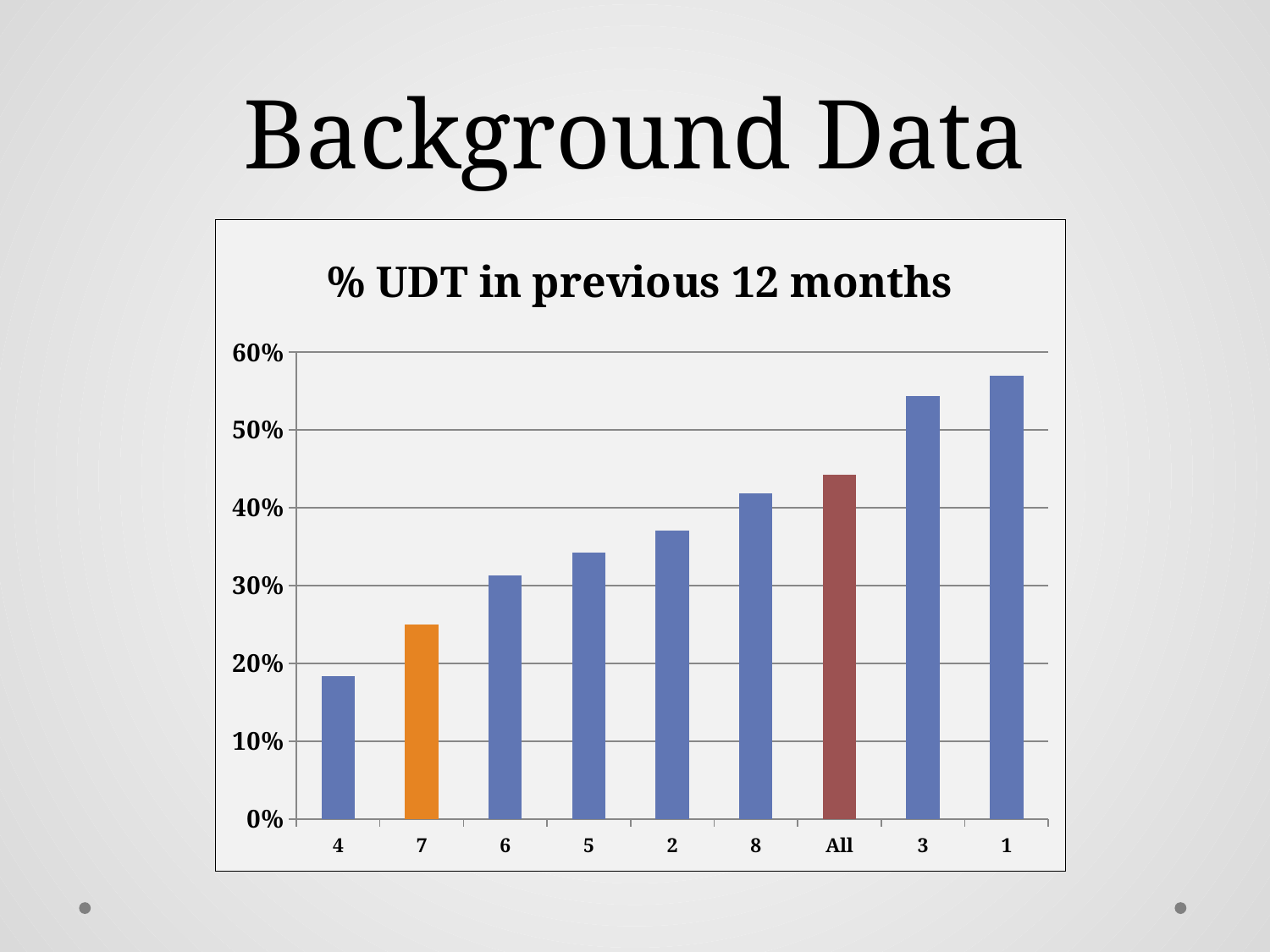
What kind of chart is shown on the slide? bar chart Which category has the highest % UDT in previous 12 months? 1 Is the value for All greater or less than 40%? greater Is the value for category 3 greater or less than 50%? greater Do the bar values rise or fall moving from left to right along the x axis? rise Is the value for category 1 greater or less than 60%? less Which category has the lowest % UDT in previous 12 months? 4 What is the title of the chart? % UDT in previous 12 months What colour is the bar for category 7? orange Which is larger, the value for category 3 or the value for category 8? 3 How many categories are shown on the x axis of the chart? 9